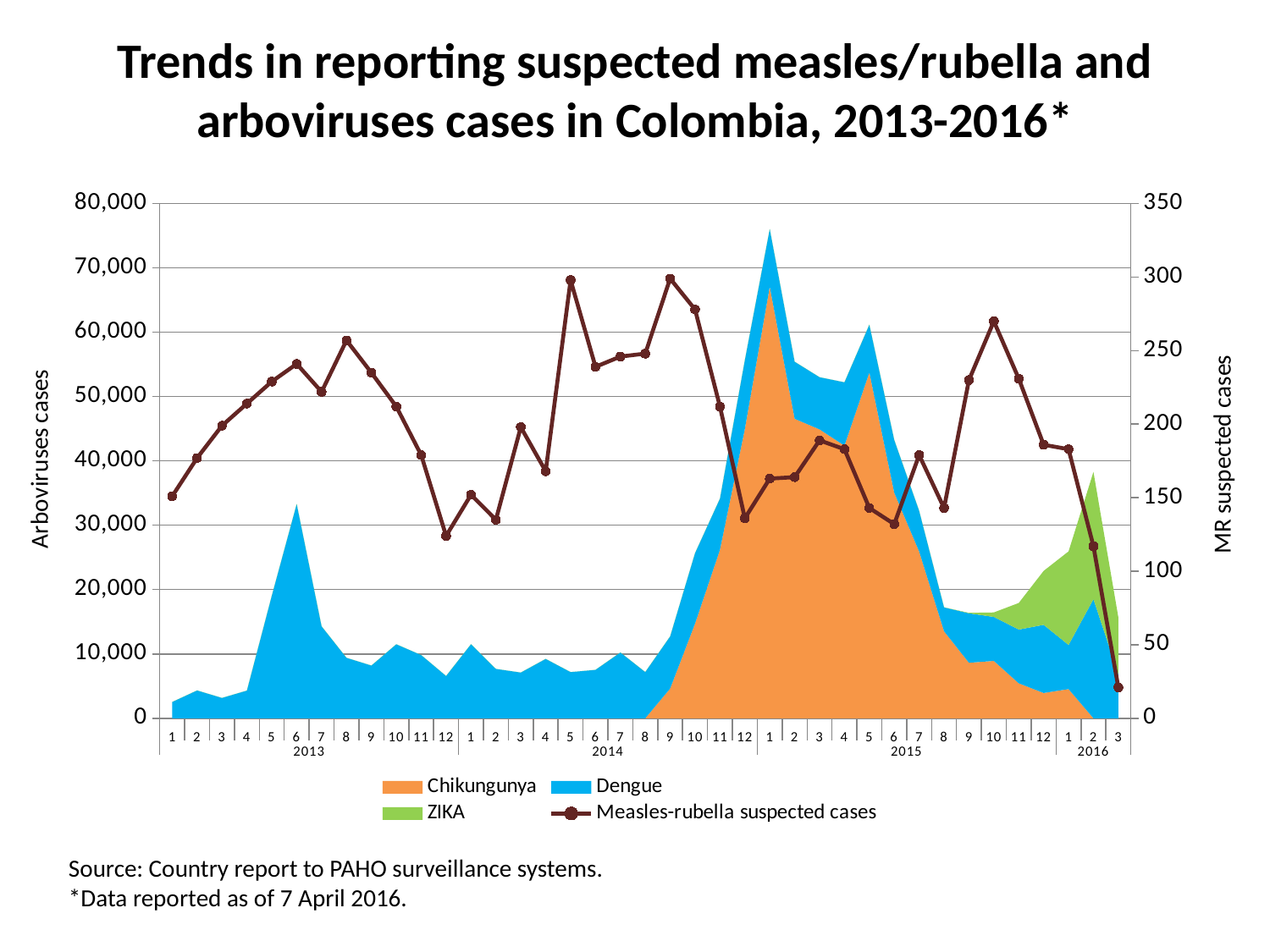
What is the title of the right-hand vertical axis? MR suspected cases In which month and year does the stacked total of arboviruses cases reach its highest point? Month 1 of 2015 What kind of chart is this? Combined stacked area and line chart Is the value of Measles-rubella suspected cases in month 5 of 2014 greater or less than 250? greater Which is higher for Measles-rubella suspected cases: month 5 of 2014 or month 12 of 2014? Month 5 of 2014 How many series does the legend list? 4 From month 1 to month 6 of 2013, does the Measles-rubella suspected cases line rise or fall? rise Is the total of arboviruses cases in month 1 of 2015 greater or less than 70,000? greater In which month and year does the Measles-rubella suspected cases line reach its lowest point? Month 3 of 2016 Which series is plotted as a line with markers rather than as a filled area? Measles-rubella suspected cases Is the value of Measles-rubella suspected cases in month 3 of 2016 greater or less than 50? less